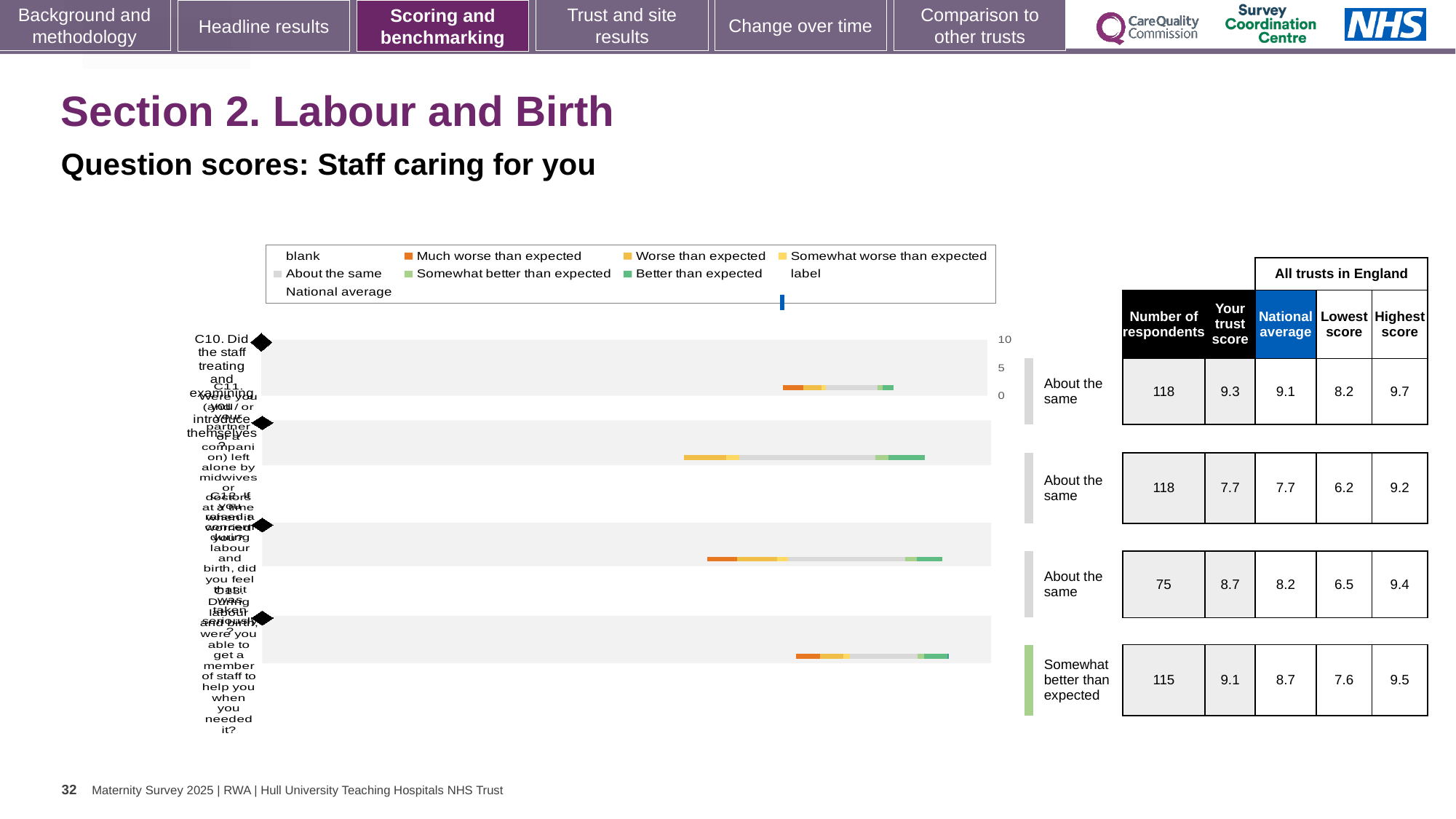
In the table beside the chart, what is the highest score among all trusts in England for the second row (C11)? 9.2 What benchmark category is shown for the fourth row (C15)? Somewhat better than expected In the table beside the chart, what is the number of respondents for the third row (C14)? 75 For the fourth row (C15), what is the difference between the trust score and the national average? 0.4 For the first row (C10), which is larger: the trust score or the national average? The trust score (9.3) In the table beside the chart, what is the national average for the fourth row (C15)? 8.7 What kind of chart is shown on the slide? Bar chart How many question rows (bars) are plotted in the chart? 4 What colour represents 'Much worse than expected' in the chart legend? Orange Which row has the lowest 'Your trust score' in the table beside the chart? The second row (C11), 7.7 In the table beside the chart, what is the 'Your trust score' for the first row (C10)? 9.3 Which row has the highest 'Your trust score' in the table beside the chart? The first row (C10), 9.3